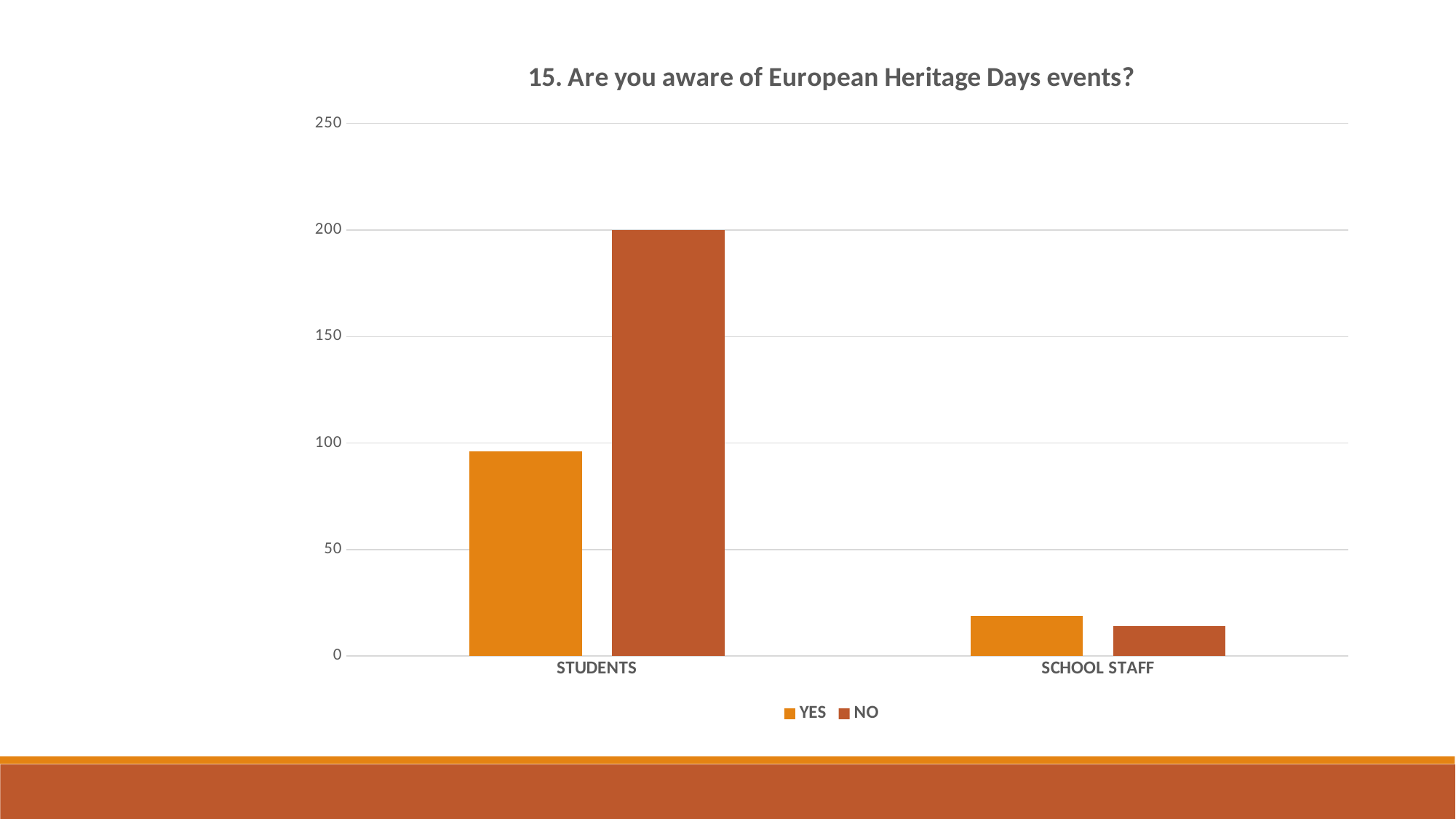
Is the NO value for STUDENTS greater or less than 150? greater For STUDENTS, which is larger, YES or NO? NO What kind of chart is shown on the slide? bar chart How many categories are shown on the x axis? 2 Is the YES value for STUDENTS greater or less than 100? less How many series does the legend list? 2 Which series is shown in the darker red-brown colour? NO What is the title of the chart? 15. Are you aware of European Heritage Days events? Which category and series has the highest bar? STUDENTS, NO Is the YES value for SCHOOL STAFF greater or less than 50? less What is the NO value for STUDENTS? 200 For SCHOOL STAFF, which is larger, YES or NO? YES